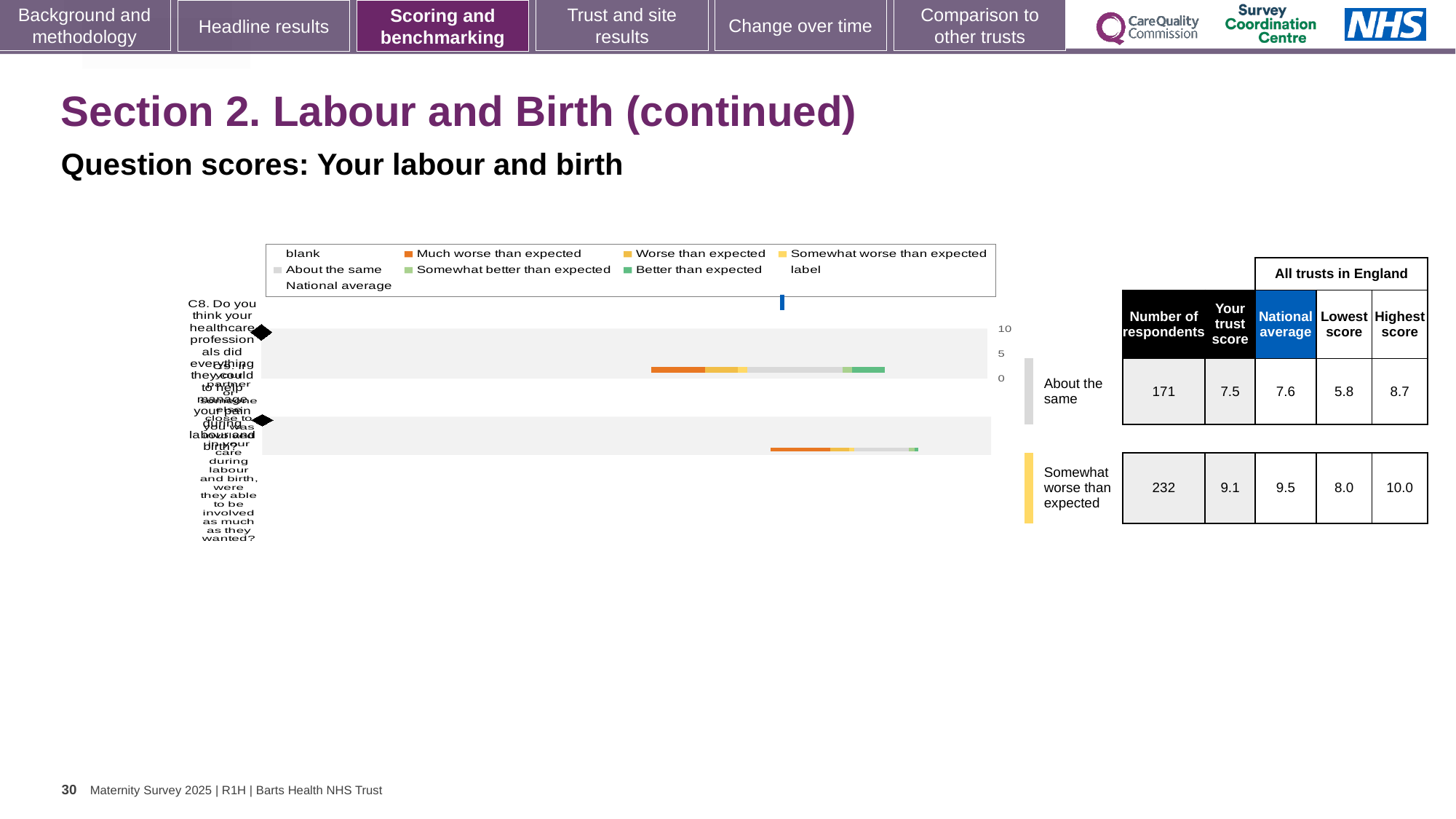
In the table next to the chart, what is the national average for the row rated 'About the same'? 7.6 In the table next to the chart, what is 'Your trust score' for the row rated 'Somewhat worse than expected'? 9.1 According to the chart legend, what does the blue vertical marker represent? National average What kind of chart is shown on the slide? bar chart How many question rows (bars) are plotted in the chart? 2 In the table next to the chart, what is the lowest score for the row rated 'Somewhat worse than expected'? 8.0 In the chart legend, what colour represents 'Much worse than expected'? orange In the table next to the chart, for the row rated 'About the same', which is larger: the trust score or the national average? National average In the table next to the chart, what is the difference between the highest score and the lowest score for the row rated 'About the same'? 2.9 In the table next to the chart, what is the highest score for the row rated 'Somewhat worse than expected'? 10.0 In the table next to the chart, what is the number of respondents for the row rated 'About the same'? 171 In the table next to the chart, what is the difference between the national average and the trust score for the row rated 'Somewhat worse than expected'? 0.4